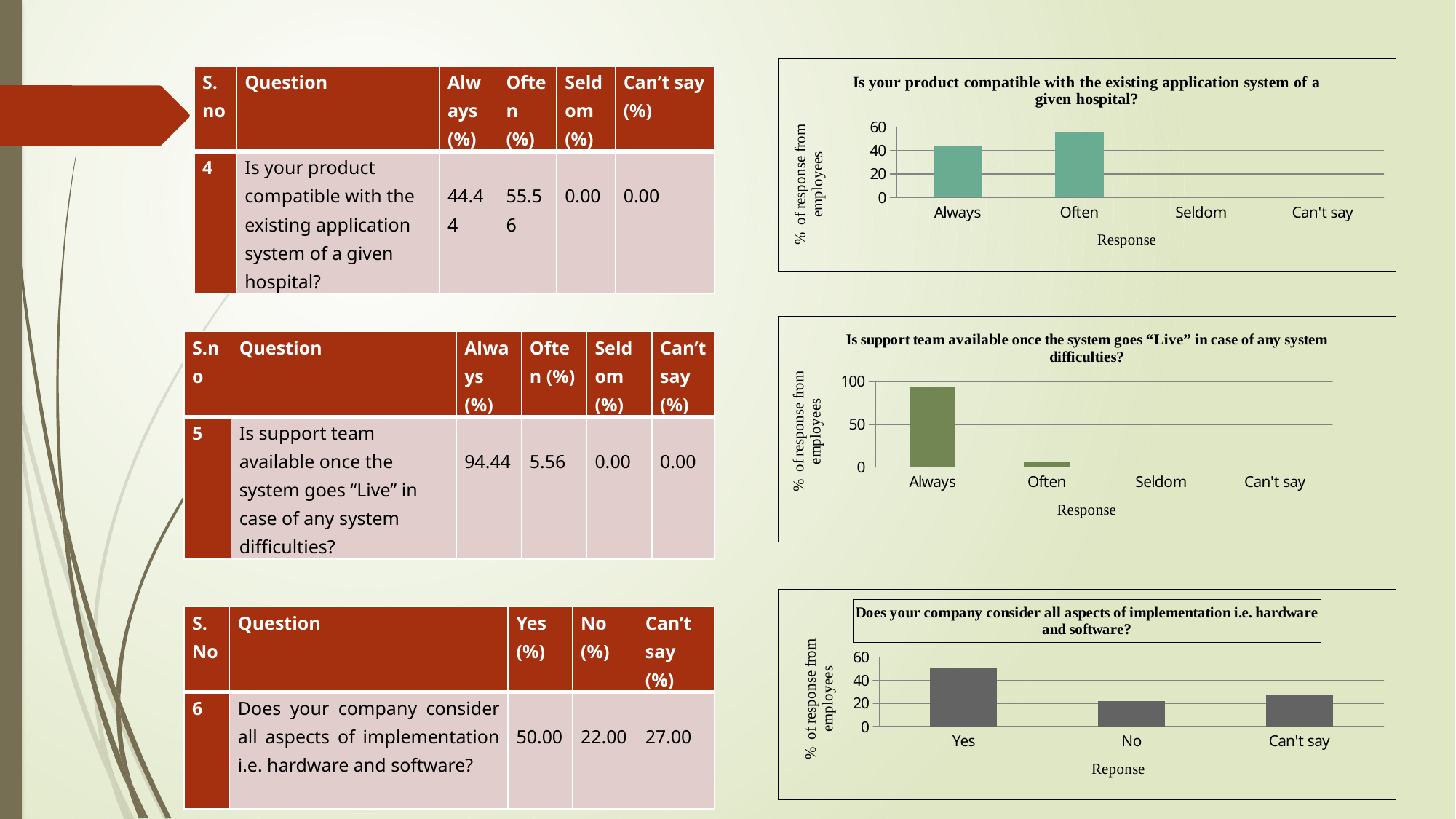
In the chart titled "Is support team available once the system goes "Live" in case of any system difficulties?", which response has the highest value? Always In the chart titled "Is support team available once the system goes "Live" in case of any system difficulties?", is the value for Often greater or less than 50? less In the chart titled "Is your product compatible with the existing application system of a given hospital?", what is the value for Often (%)? 55.56 How many response categories are shown on the x axis of the chart titled "Does your company consider all aspects of implementation i.e. hardware and software?"? 3 What kind of chart is the chart titled "Is your product compatible with the existing application system of a given hospital?"? bar chart In the chart titled "Does your company consider all aspects of implementation i.e. hardware and software?", which is larger, the value for No or the value for Can't say? Can't say In the chart titled "Is your product compatible with the existing application system of a given hospital?", which response has the highest value? Often In the chart titled "Does your company consider all aspects of implementation i.e. hardware and software?", what is the difference between the value for Yes and the value for No? 28.00 In the chart titled "Is support team available once the system goes "Live" in case of any system difficulties?", what is the value for Always (%)? 94.44 How many response categories are shown on the x axis of the chart titled "Is your product compatible with the existing application system of a given hospital?"? 4 In the chart titled "Does your company consider all aspects of implementation i.e. hardware and software?", which response has the highest value? Yes In the chart titled "Is your product compatible with the existing application system of a given hospital?", is the value for Always greater or less than 40? greater